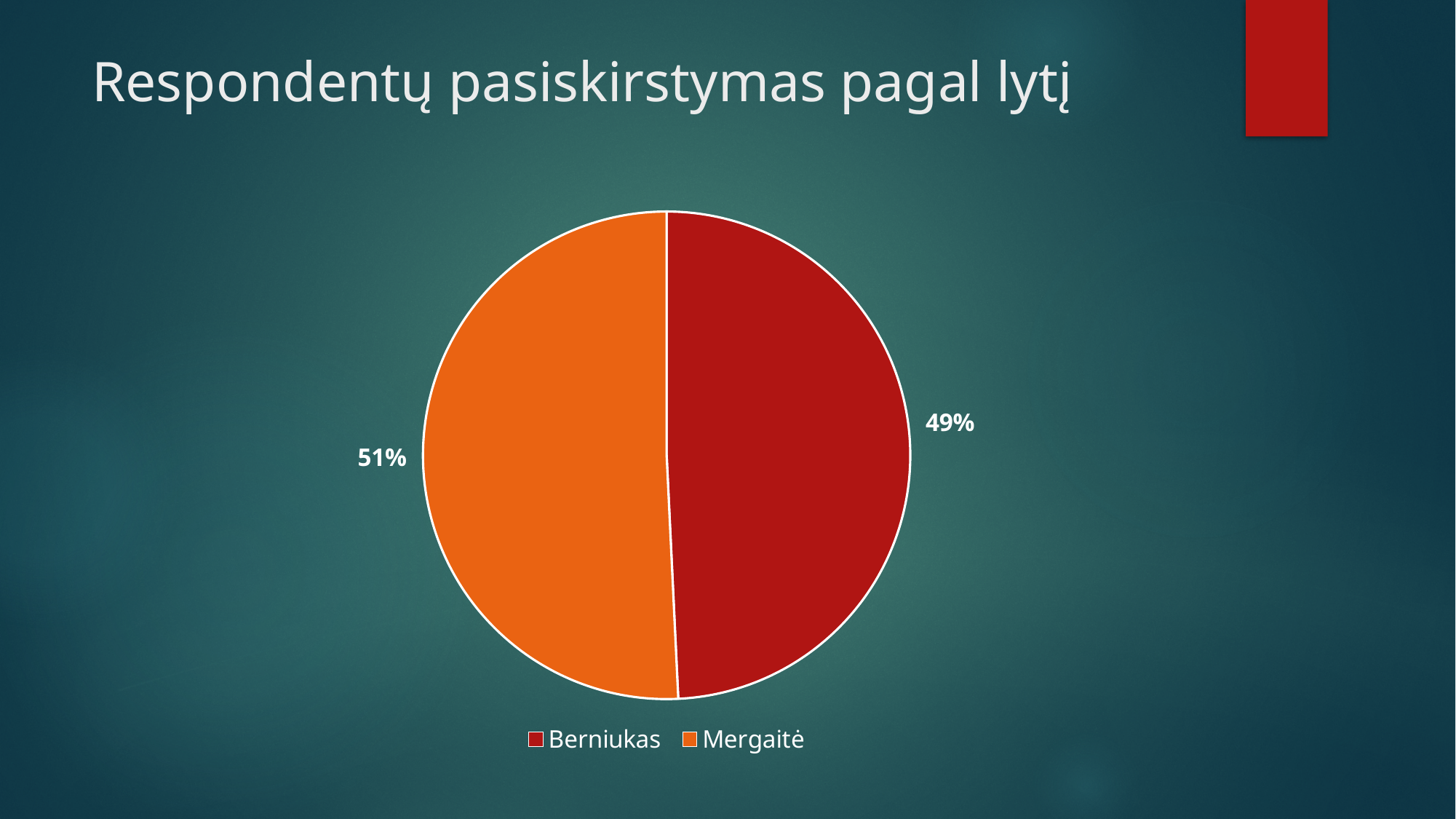
What share of the pie does Mergaitė have? 51% What colour is the Berniukas slice? Red Which category has the smallest slice of the pie? Berniukas What is the difference in percentage points between the Mergaitė and Berniukas slices? 2 percentage points What is the title of the slide? Respondentų pasiskirstymas pagal lytį Which category has the largest slice of the pie? Mergaitė Which is larger, the Berniukas slice or the Mergaitė slice? Mergaitė How many categories are shown in the pie chart? 2 What share of the pie does Berniukas have? 49% What kind of chart is shown on the slide? Pie chart